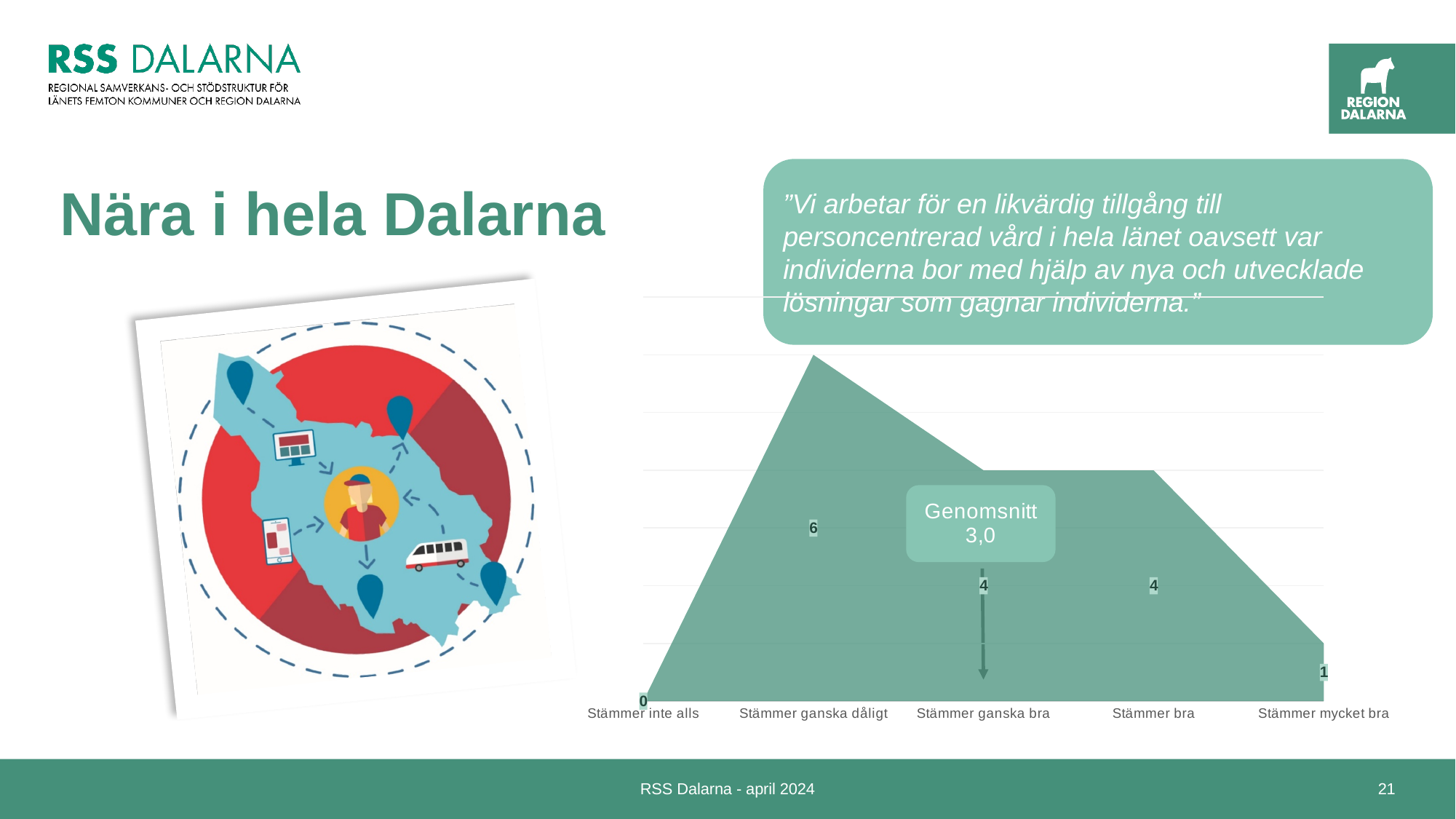
What is the value for "Stämmer ganska dåligt"? 6 What is the value for "Stämmer inte alls"? 0 Which is larger, the value for "Stämmer ganska bra" or the value for "Stämmer mycket bra"? Stämmer ganska bra What is the total of all the values plotted in the chart? 15 Which category has the lowest value? Stämmer inte alls What is the value for "Stämmer mycket bra"? 1 What average (Genomsnitt) value is shown in the box on the chart? 3,0 What kind of chart is shown on the slide? Area chart Which category has the highest value? Stämmer ganska dåligt What is the difference between the values for "Stämmer ganska dåligt" and "Stämmer mycket bra"? 5 What is the value for "Stämmer bra"? 4 How many categories are shown on the x axis of the chart? 5